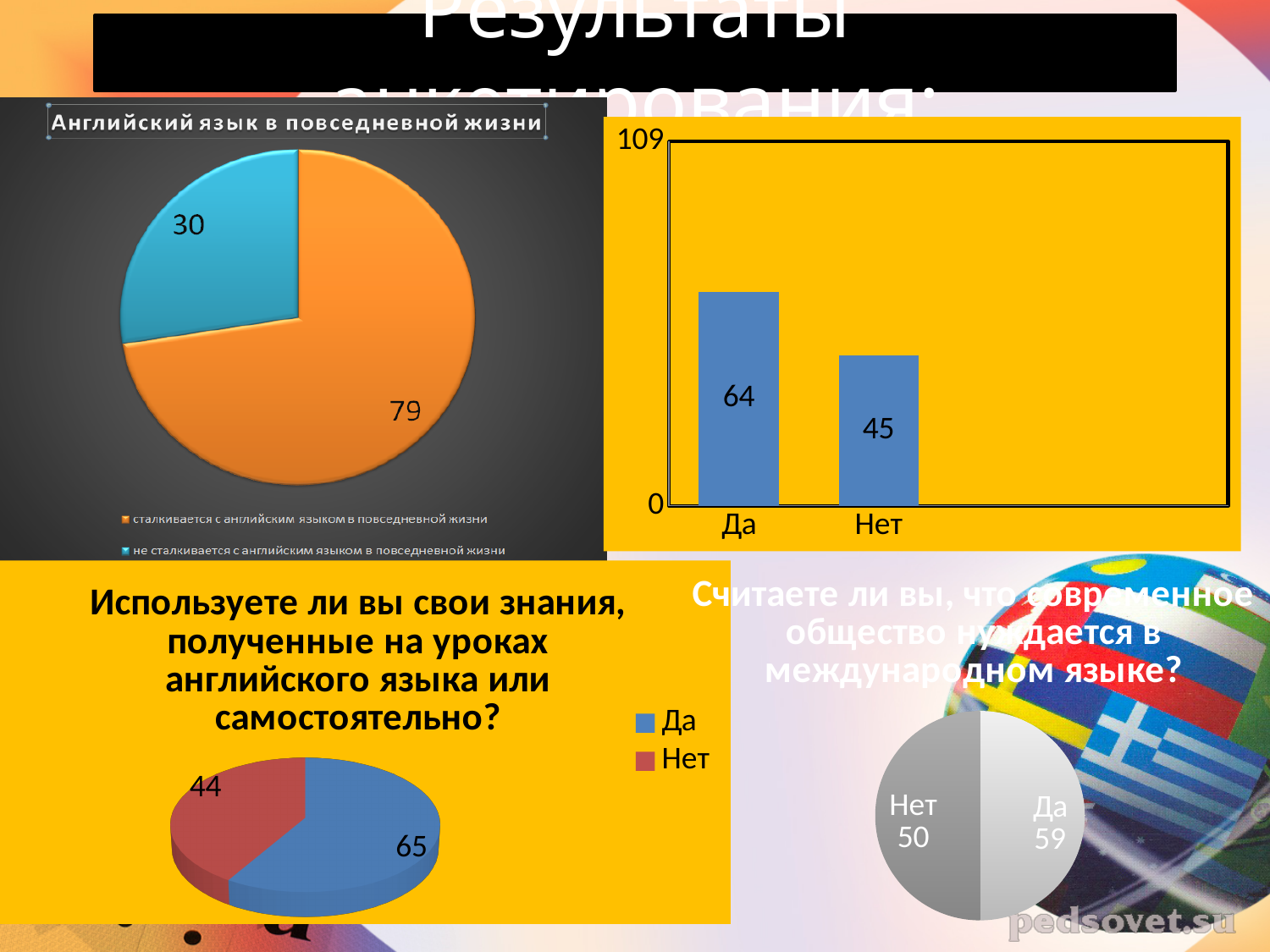
In the top-right bar chart, what is the value for 'Нет'? 45 In the bottom-right pie chart 'Считаете ли вы, что современное общество нуждается в международном языке?', what is the difference between the 'Да' and 'Нет' values? 9 In the top-right bar chart, which category has the higher value, 'Да' or 'Нет'? Да In the bottom-right pie chart 'Считаете ли вы, что современное общество нуждается в международном языке?', what value is shown for 'Да'? 59 In the top-right bar chart, what is the value for 'Да'? 64 In the bottom-left pie chart 'Используете ли вы свои знания, полученные на уроках английского языка или самостоятельно?', what value is shown for 'Да'? 65 What type of chart is the top-right chart with the 'Да' and 'Нет' categories? bar chart In the top-left pie chart 'Английский язык в повседневной жизни', what value is shown for the orange slice (сталкивается с английским языком в повседневной жизни)? 79 In the top-right bar chart, how many bars are plotted? 2 In the top-left pie chart 'Английский язык в повседневной жизни', what value is shown for the blue slice (не сталкивается с английским языком в повседневной жизни)? 30 In the bottom-left pie chart 'Используете ли вы свои знания, полученные на уроках английского языка или самостоятельно?', what value is shown for 'Нет'? 44 In the top-left pie chart 'Английский язык в повседневной жизни', what is the difference between the two slice values? 49